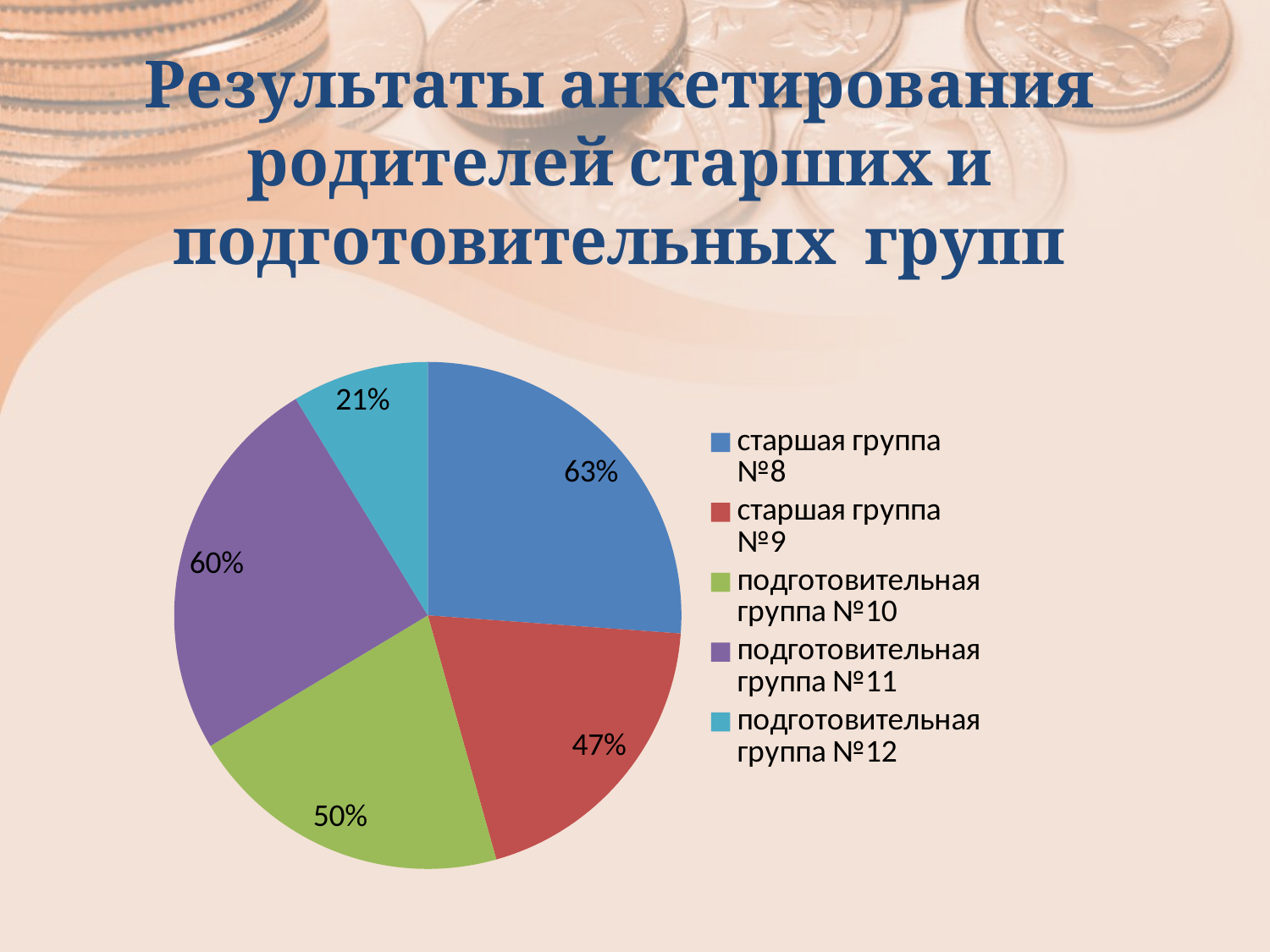
Which group has the highest value in the pie chart? старшая группа №8 What value is shown for подготовительная группа №11? 60% Which group has the lowest value in the pie chart? подготовительная группа №12 What value is shown for подготовительная группа №10? 50% How many slices does the pie chart have? 5 Which is larger: the value for подготовительная группа №11 or подготовительная группа №10? подготовительная группа №11 What is the difference between the values for старшая группа №8 and старшая группа №9? 16% What colour is the slice for подготовительная группа №12? teal (light blue) What value is shown for старшая группа №8? 63% What type of chart is shown on the slide? pie chart What value is shown for старшая группа №9? 47% What value is shown for подготовительная группа №12? 21%